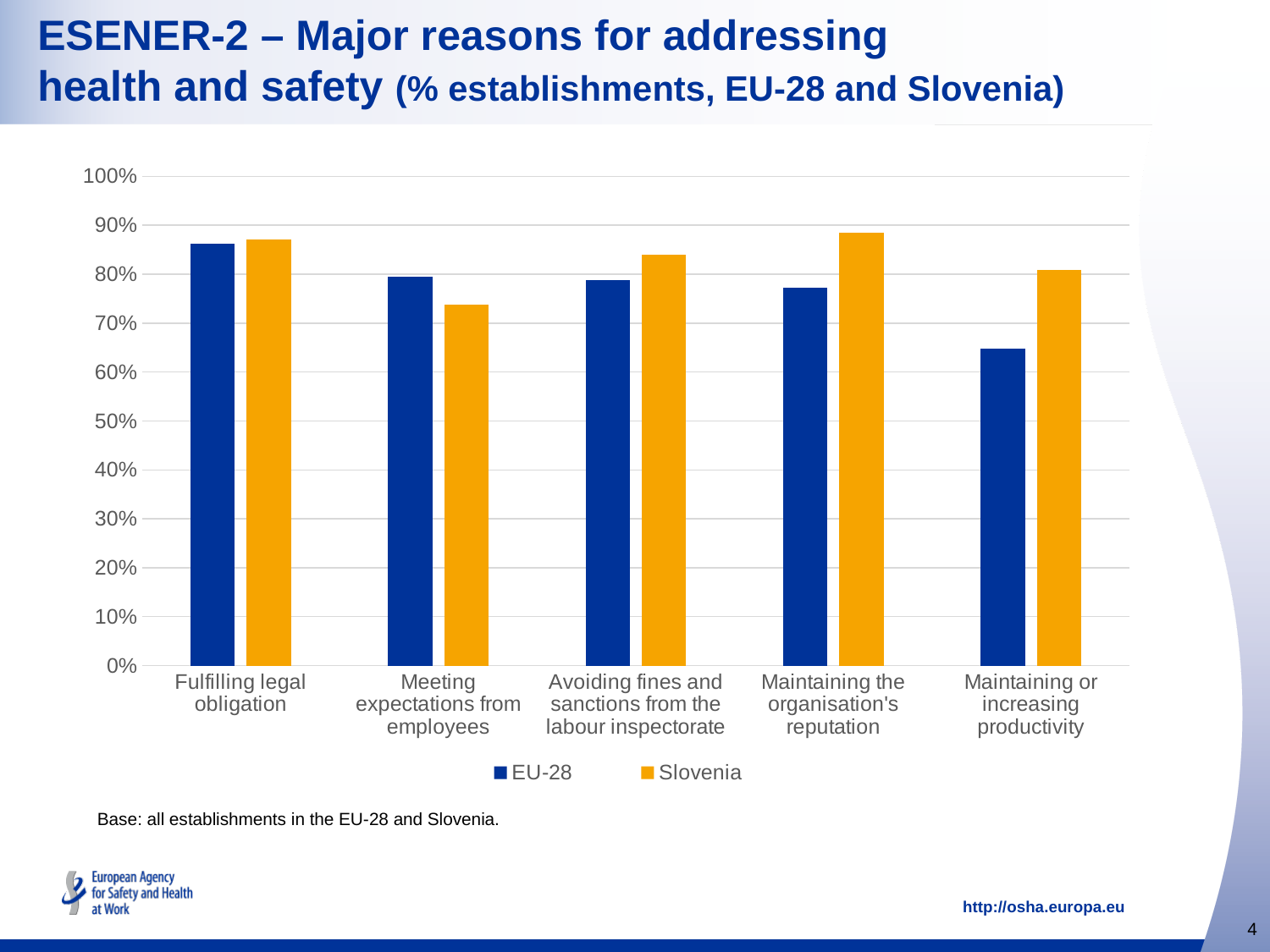
Is the Slovenia value for Meeting expectations from employees greater or less than 80%? less How many series does the legend list? 2 For which reason is the Slovenia value lowest? Meeting expectations from employees Is the Slovenia value for Maintaining the organisation's reputation greater or less than 80%? greater Which series is shown in orange? Slovenia What kind of chart is shown on the slide? bar chart Is the EU-28 value for Maintaining or increasing productivity greater or less than 70%? less For Meeting expectations from employees, which is larger: the EU-28 value or the Slovenia value? EU-28 For which reason is the EU-28 value highest? Fulfilling legal obligation For Maintaining or increasing productivity, which is larger: the EU-28 value or the Slovenia value? Slovenia How many reason categories are shown on the x axis? 5 For which reason is the EU-28 value lowest? Maintaining or increasing productivity